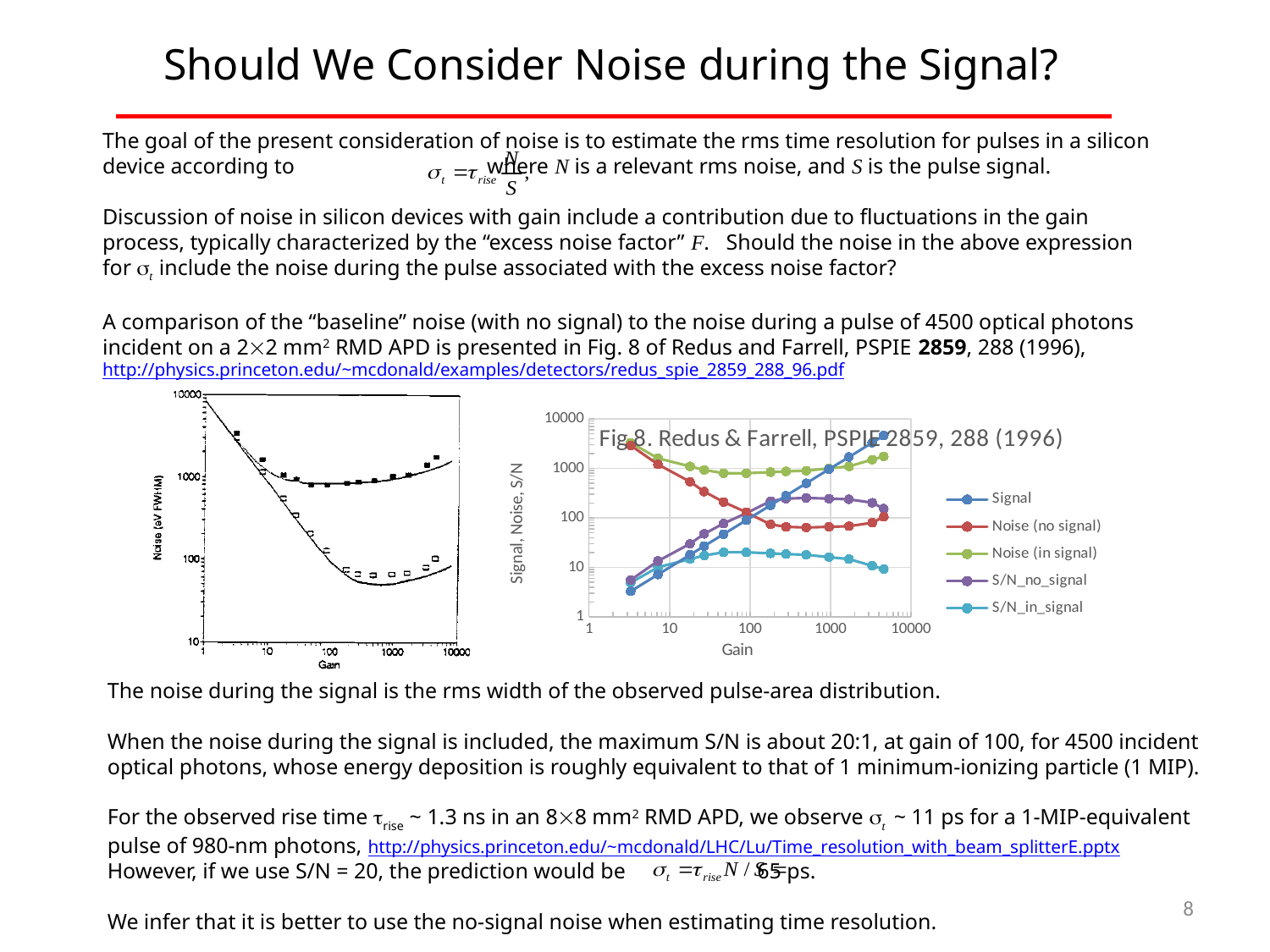
What is the title of the right-hand chart? Fig.8. Redus & Farrell, PSPIE 2859, 288 (1996) On the right-hand chart, is the value of Noise (no signal) at a gain of 1000 greater or less than 100? less On the right-hand chart, does the Signal series rise or fall as gain increases? Rises On the right-hand chart, at a gain of 1000, which is larger: Signal or Noise (no signal)? Signal On the right-hand chart, is the value of S/N_in_signal at a gain of 100 greater or less than 100? less On the right-hand chart, how many series does the legend list? 5 On the right-hand chart, what is the label of the x axis? Gain On the right-hand chart, at a gain of 10, which is larger: Signal or Noise (no signal)? Noise (no signal) On the right-hand chart, is the value of Signal at a gain of 10 greater or less than 100? less On the left-hand chart, what is the label of the y axis? Noise (eV FWHM) What kind of chart is the right-hand chart? Line chart